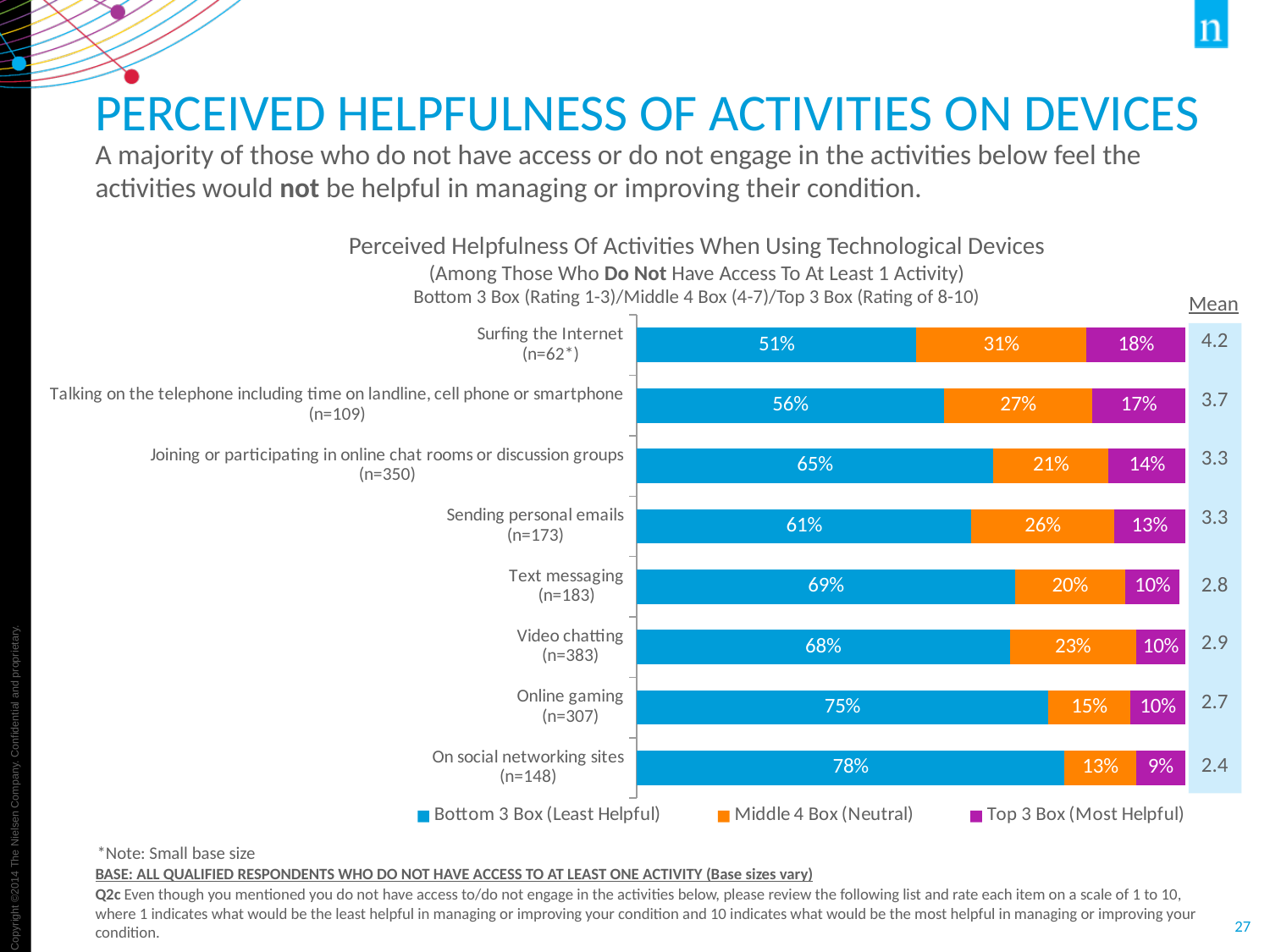
What is the Middle 4 Box (Neutral) value for Video chatting? 23% What is the Top 3 Box (Most Helpful) value for Talking on the telephone including time on landline, cell phone or smartphone? 17% Which colour represents the Top 3 Box (Most Helpful) series? Purple What is the difference between the Bottom 3 Box values for Online gaming and Surfing the Internet? 24 percentage points Which activity has the highest Bottom 3 Box (Least Helpful) percentage? On social networking sites Which activity has the lowest Top 3 Box (Most Helpful) percentage? On social networking sites How many series does the legend list? 3 How many activities are shown in the chart? 8 What kind of chart is shown on the slide? Stacked bar chart What percentage of respondents rated Surfing the Internet in the Bottom 3 Box (Least Helpful)? 51% What is the mean rating shown for Joining or participating in online chat rooms or discussion groups? 3.3 Which has a larger Middle 4 Box (Neutral) value: Sending personal emails or Text messaging? Sending personal emails